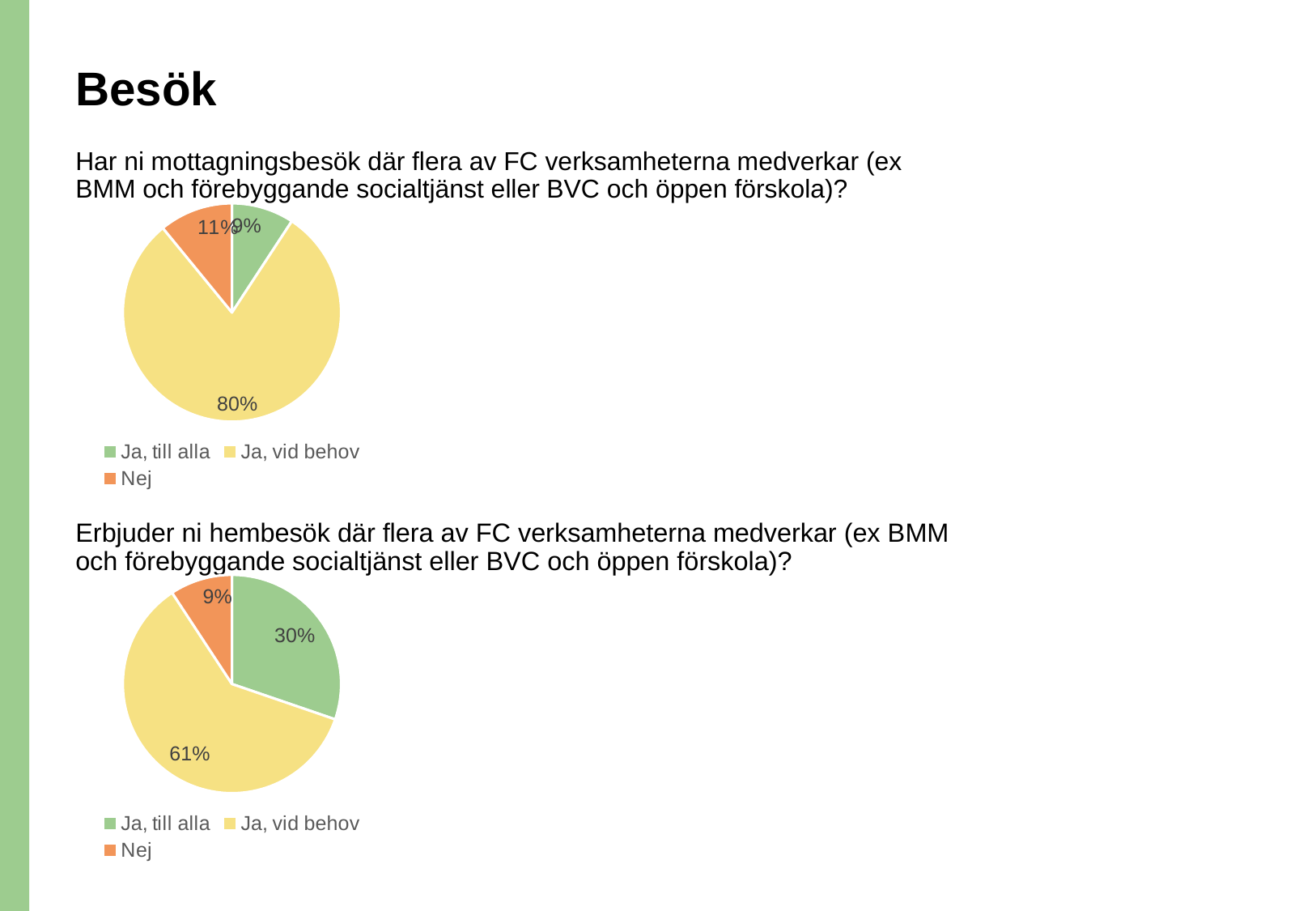
On the top pie chart (mottagningsbesök), what share is 'Ja, vid behov'? 80% On the top pie chart (mottagningsbesök), which category has the largest share? Ja, vid behov On the bottom pie chart (hembesök), which category has the smallest share? Nej On the bottom pie chart (hembesök), which colour represents 'Nej'? Orange How many categories does the legend of the bottom pie chart (hembesök) list? 3 On the bottom pie chart (hembesök), what share is 'Nej'? 9% On the bottom pie chart (hembesök), what share is 'Ja, till alla'? 30% On the top pie chart (mottagningsbesök), what share is 'Nej'? 11% On the bottom pie chart (hembesök), what share is 'Ja, vid behov'? 61% On the bottom pie chart (hembesök), what is the difference between 'Ja, vid behov' and 'Ja, till alla'? 31 percentage points On the top pie chart (mottagningsbesök), which is larger, 'Nej' or 'Ja, till alla'? Nej What type of chart is used for the top question (mottagningsbesök)? Pie chart